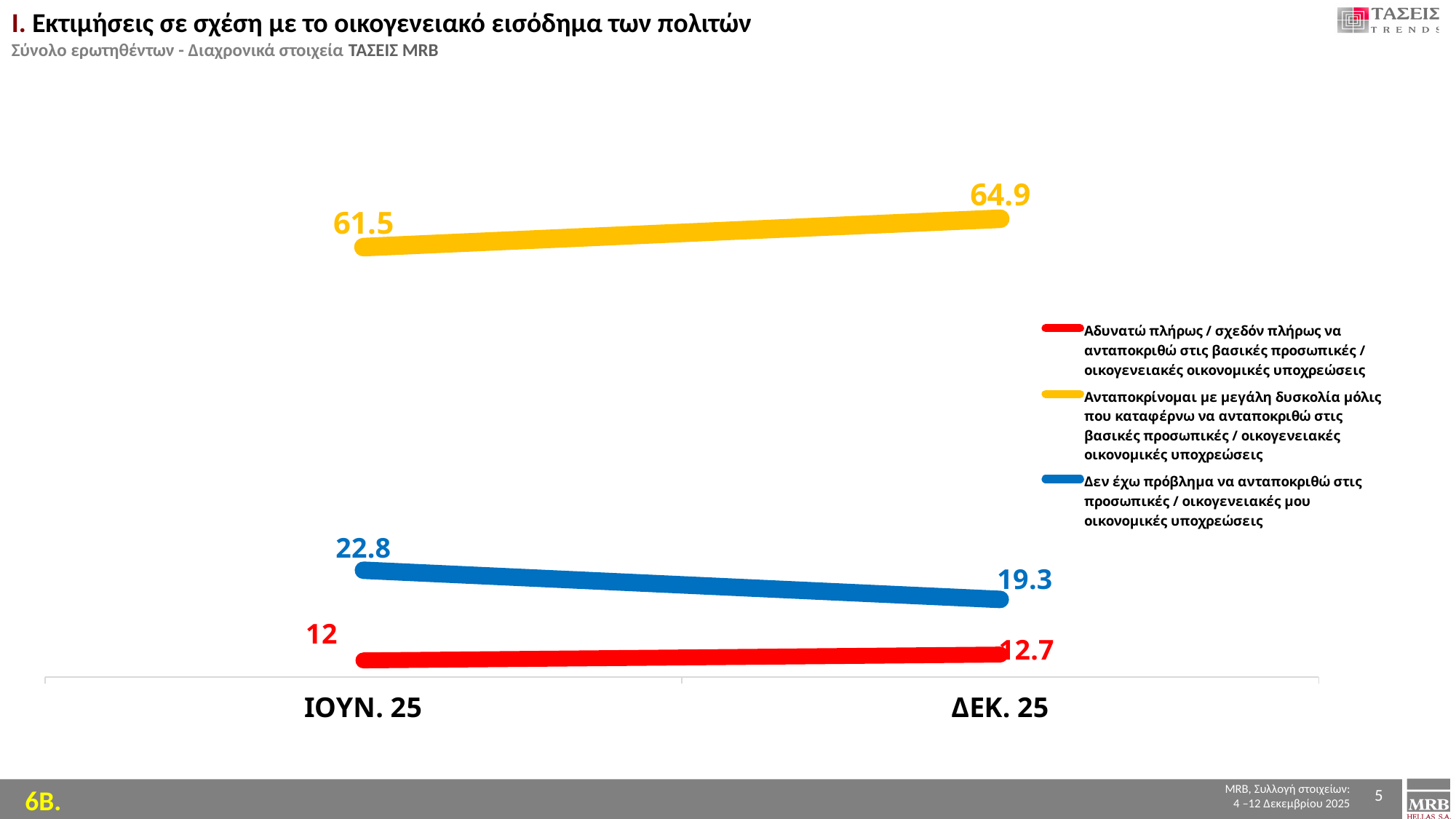
What is the value of the red series (Αδυνατώ πλήρως / σχεδόν πλήρως...) for ΙΟΥΝ. 25? 12 Which is larger: the blue series value in ΙΟΥΝ. 25 or the red series value in ΔΕΚ. 25? the blue series value in ΙΟΥΝ. 25 What is the value of the yellow series (Ανταποκρίνομαι με μεγάλη δυσκολία...) for ΔΕΚ. 25? 64.9 What is the value of the blue series (Δεν έχω πρόβλημα να ανταποκριθώ...) for ΔΕΚ. 25? 19.3 What type of chart is shown on the slide? line chart Which series has the highest value in ΔΕΚ. 25? Ανταποκρίνομαι με μεγάλη δυσκολία μόλις που καταφέρνω να ανταποκριθώ στις βασικές προσωπικές / οικογενειακές οικονομικές υποχρεώσεις Which series has the lowest value in ΙΟΥΝ. 25? Αδυνατώ πλήρως / σχεδόν πλήρως να ανταποκριθώ στις βασικές προσωπικές / οικογενειακές οικονομικές υποχρεώσεις What is the value of the yellow series (Ανταποκρίνομαι με μεγάλη δυσκολία...) for ΙΟΥΝ. 25? 61.5 Does the blue series (Δεν έχω πρόβλημα να ανταποκριθώ...) rise or fall from ΙΟΥΝ. 25 to ΔΕΚ. 25? fall By how much did the yellow series change from ΙΟΥΝ. 25 to ΔΕΚ. 25? 3.4 How many time points are shown on the x axis? 2 How many series does the legend list? 3